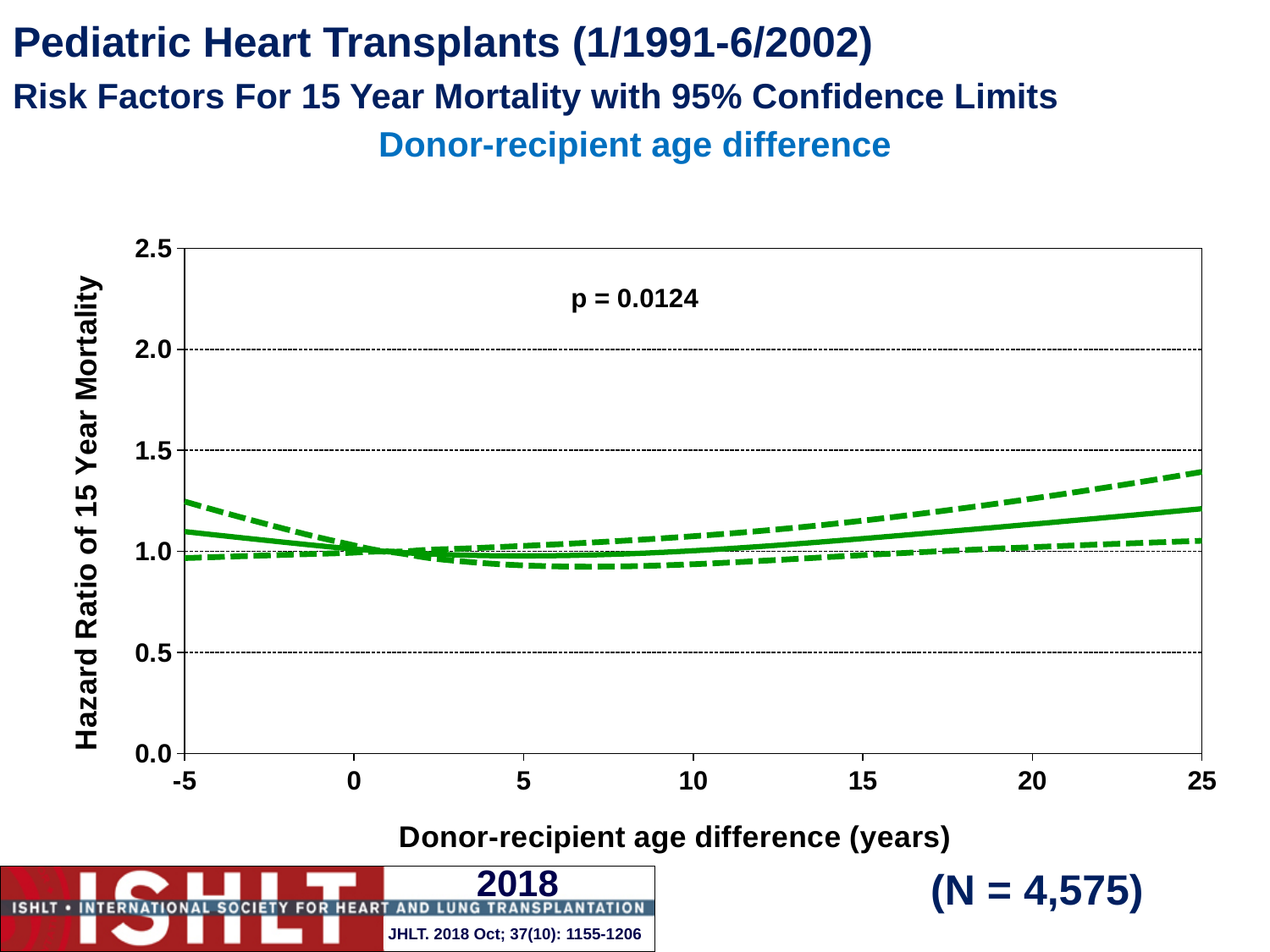
Is the upper 95% confidence limit (upper dashed line) at a donor-recipient age difference of 25 years greater or less than 1.5? less What kind of chart is shown on the slide? line chart Is the hazard ratio (solid line) higher at a donor-recipient age difference of 25 years or at 10 years? 25 years Is the hazard ratio (solid line) at a donor-recipient age difference of -5 years greater or less than 1.0? greater What is the highest value shown on the y axis of the chart? 2.5 Does the hazard ratio (solid line) rise or fall as the donor-recipient age difference increases from -5 to 0 years? fall What is the sample size (N) shown on the slide? 4,575 Is the lower 95% confidence limit (lower dashed line) at a donor-recipient age difference of 5 years greater or less than 1.0? less What p-value is printed on the chart? p = 0.0124 Does the hazard ratio (solid line) rise or fall as the donor-recipient age difference increases from 10 to 25 years? rise